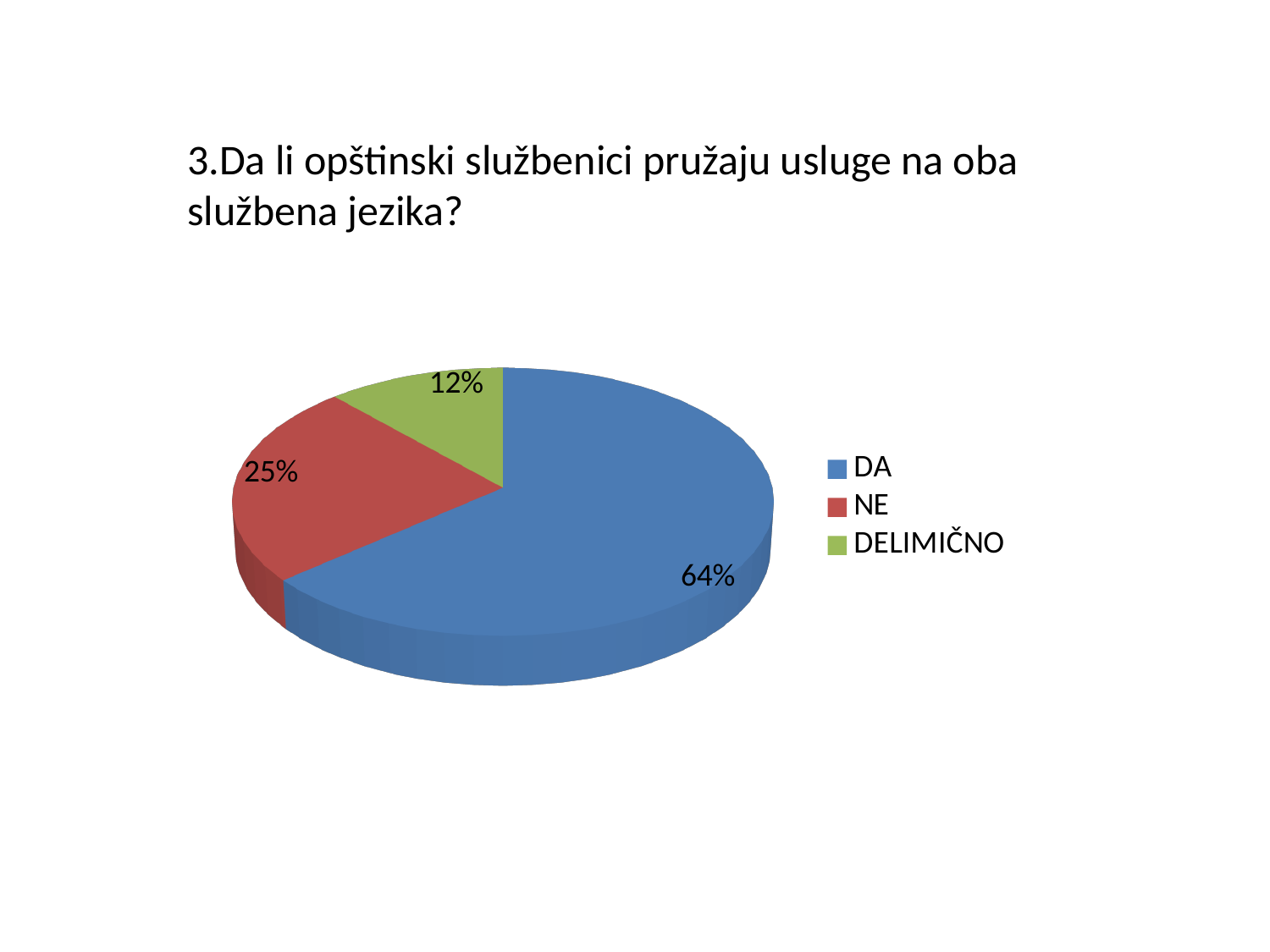
What share of the pie does DA represent? 64% Which category has the largest slice of the pie? DA What kind of chart is shown on the slide? Pie chart How many categories are shown in the pie chart? 3 What colour is the DA slice in the pie chart? Blue What is the difference in percentage points between the NE and DELIMIČNO slices? 13 What share of the pie does NE represent? 25% Which is larger, the NE slice or the DELIMIČNO slice? NE What is the difference in percentage points between the DA and NE slices? 39 Which category has the smallest slice of the pie? DELIMIČNO What share of the pie does DELIMIČNO represent? 12% Which category is shown in green in the legend? DELIMIČNO